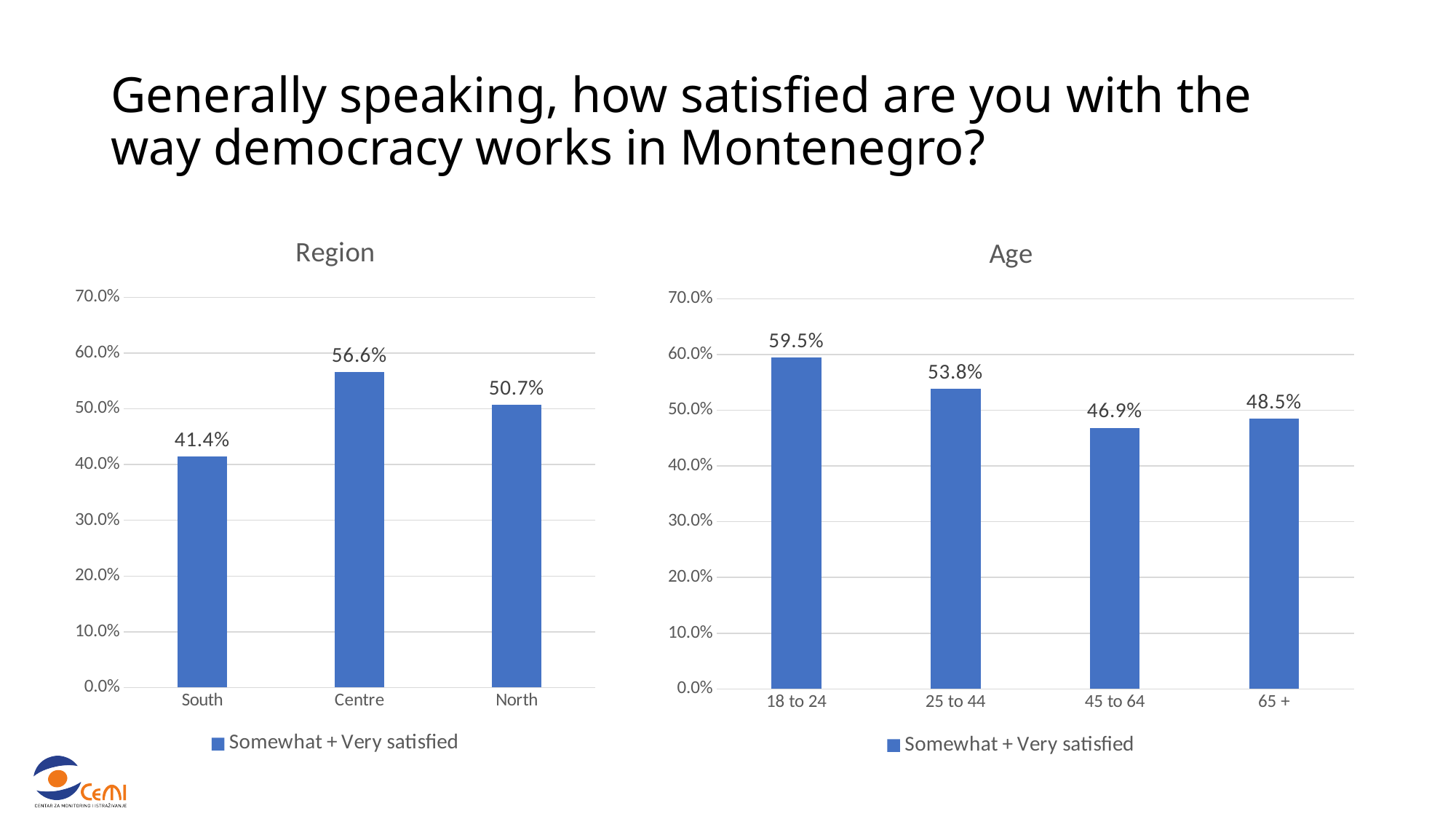
What series does the legend of the Region chart list? Somewhat + Very satisfied In the Age chart, which is larger, the value for 65 + or the value for 45 to 64? 65 + In the Region chart, which region has the lowest value? South In the Age chart, which age group has the lowest value? 45 to 64 In the Age chart, what is the difference between 18 to 24 and 65 +? 11.0% In the Region chart, what is the value for Centre? 56.6% In the Region chart, what is the difference between Centre and South? 15.2% In the Age chart, how many age groups are shown? 4 What kind of chart is the Age chart? Bar chart In the Age chart, what is the value for 25 to 44? 53.8% In the Age chart, which age group has the highest value? 18 to 24 In the Region chart, how many regions are shown? 3